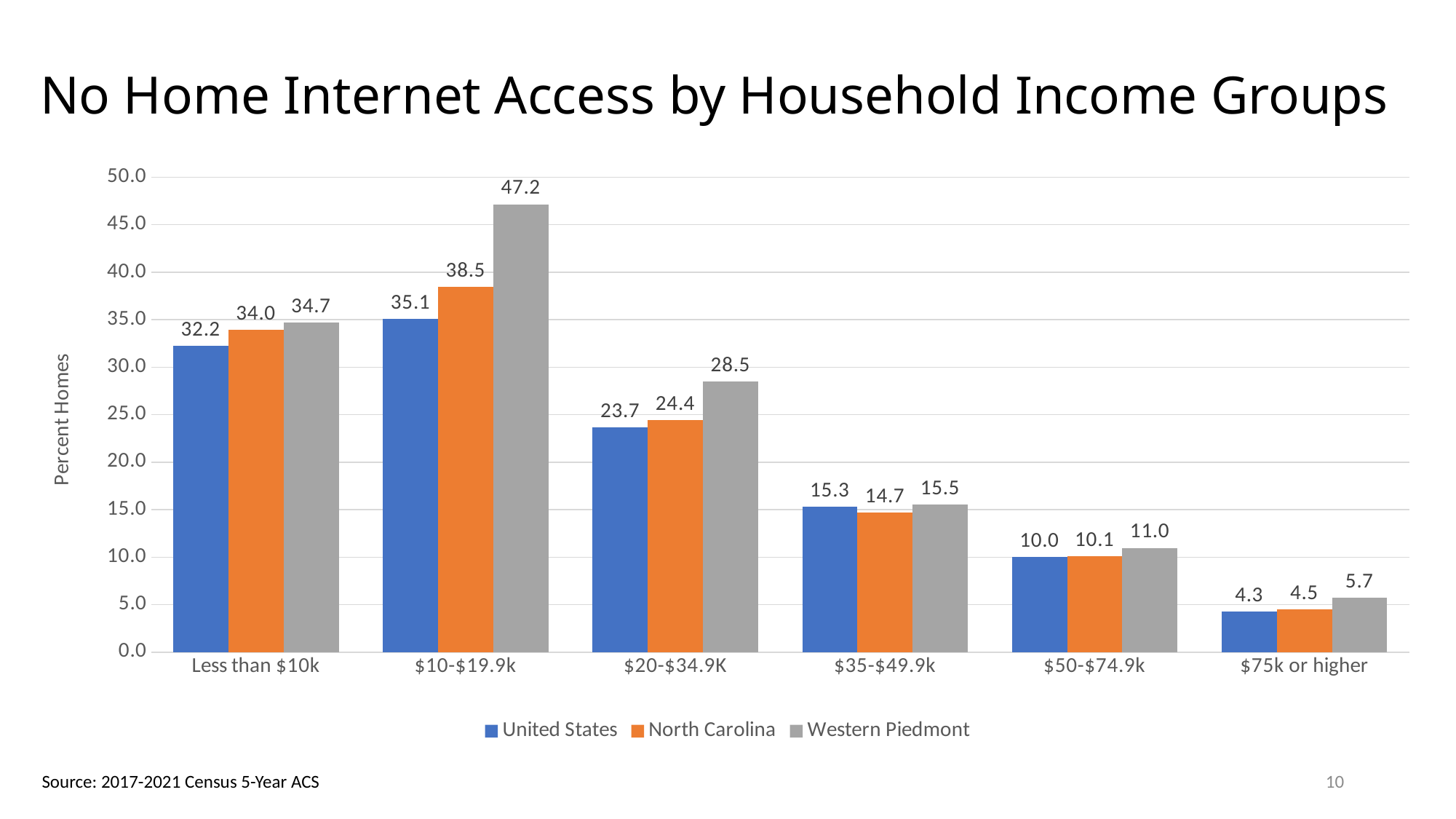
What is the value for North Carolina in the $75k or higher income group? 4.5 What is the difference between the North Carolina and United States values in the $20-$34.9K income group? 0.7 What is the value for United States in the $20-$34.9K income group? 23.7 In the $35-$49.9k income group, which is larger: the United States value or the North Carolina value? United States What is the value for Western Piedmont in the $10-$19.9k income group? 47.2 Which income group has the highest value for Western Piedmont? $10-$19.9k Which income group has the lowest value for United States? $75k or higher How many income groups are shown on the x axis? 6 What is the difference between the Western Piedmont and United States values in the $10-$19.9k income group? 12.1 What is the label of the y axis? Percent Homes What kind of chart is shown on the slide? Bar chart How many series does the legend list? 3